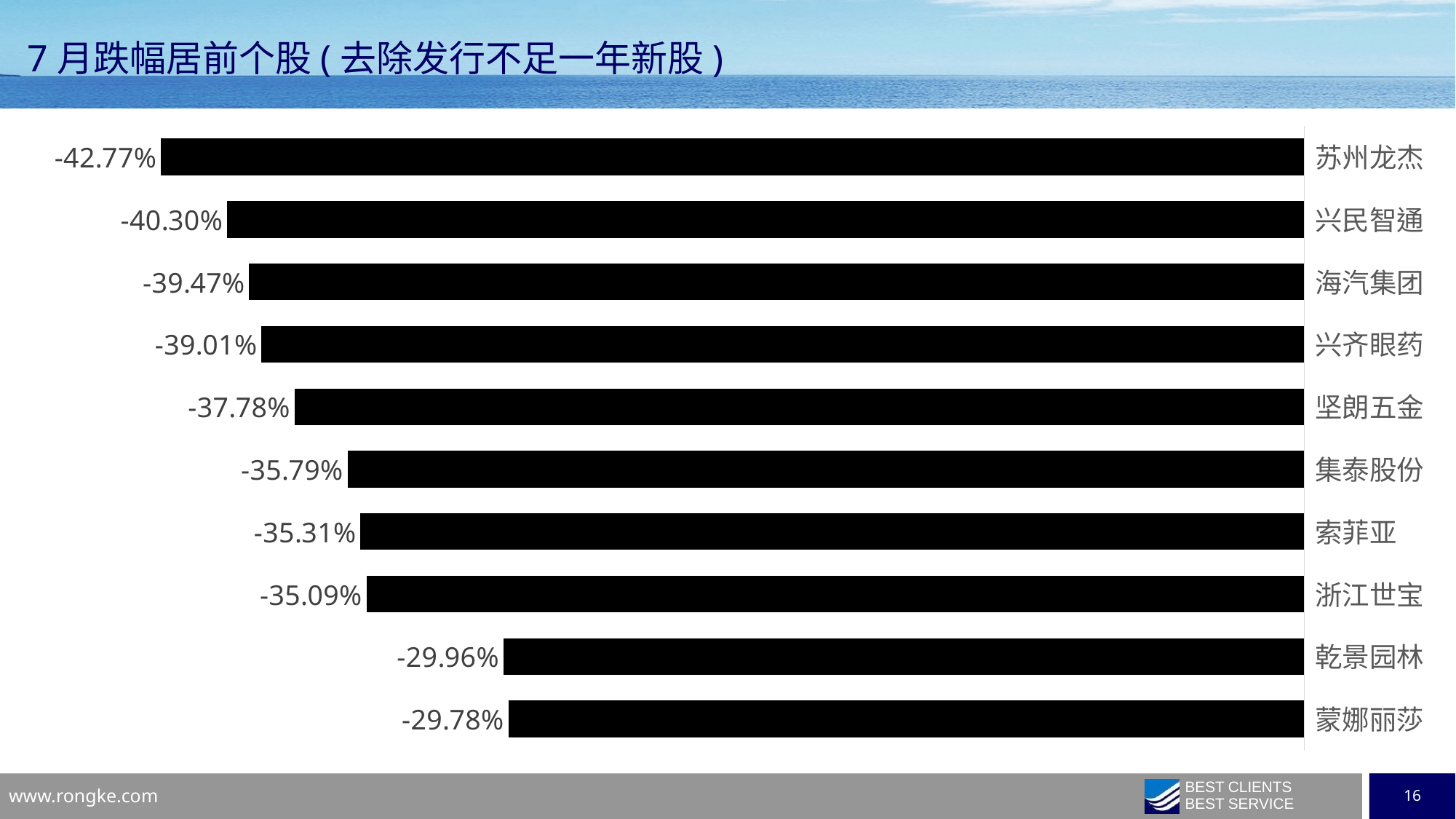
What is the title of the chart? 7月跌幅居前个股(去除发行不足一年新股) What is the value for 蒙娜丽莎? -29.78% What is the value for 索菲亚? -35.31% What is the difference between the values for 乾景园林 and 蒙娜丽莎? 0.18 percentage points What is the value for 苏州龙杰? -42.77% What kind of chart is shown on the slide? Bar chart Which has a larger decline, 海汽集团 or 集泰股份? 海汽集团 What is the value for 坚朗五金? -37.78% Which stock has the largest decline (lowest value) on the chart? 苏州龙杰 How many stocks are shown on the chart? 10 Which stock has the smallest decline (highest value) on the chart? 蒙娜丽莎 What is the difference between the values for 苏州龙杰 and 兴民智通? 2.47 percentage points